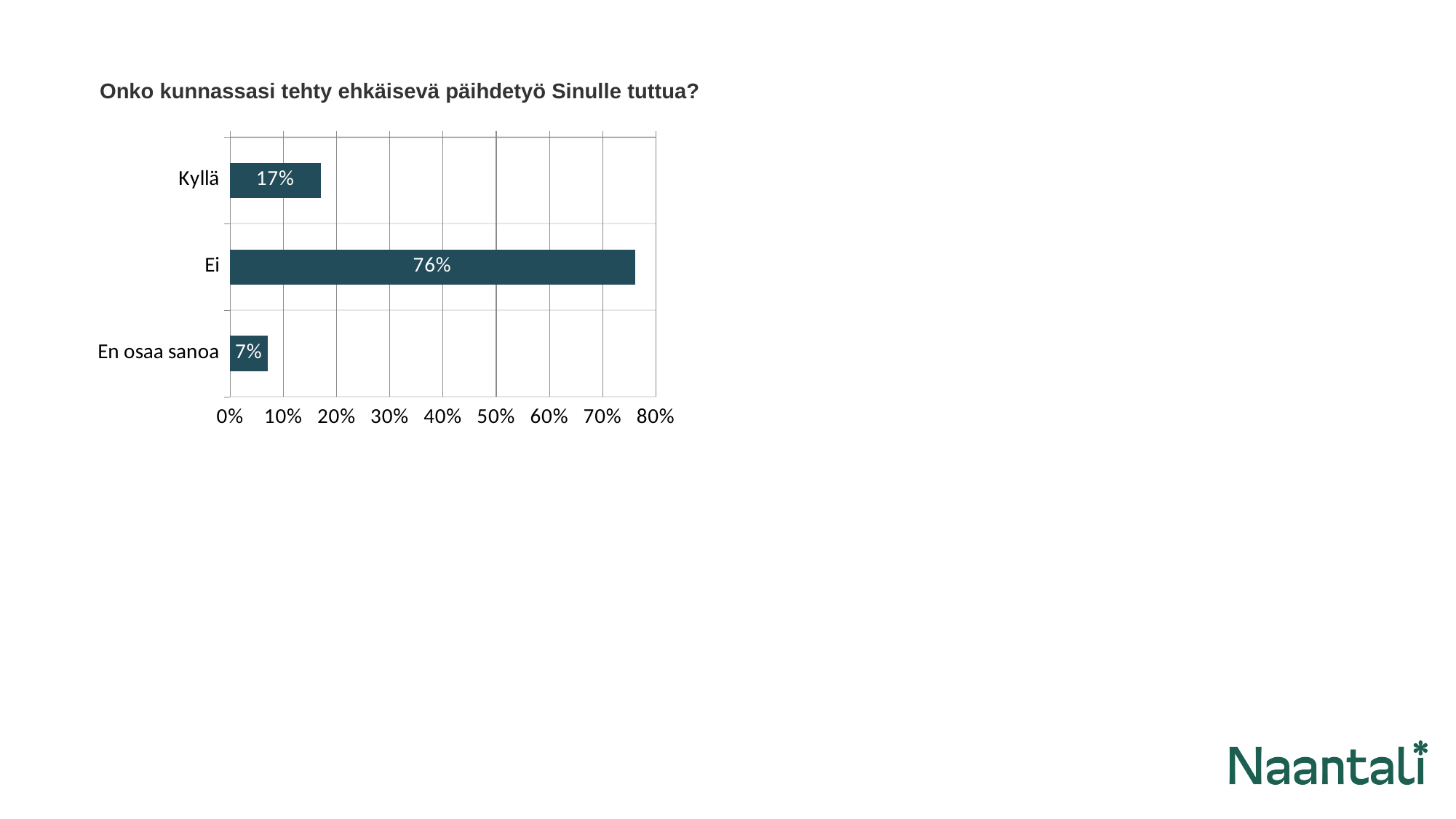
What kind of chart is shown on the slide? bar chart What is the difference between the values for Kyllä and En osaa sanoa? 10% Which category has the lowest value? En osaa sanoa Is the value for Ei greater or less than 50%? greater What is the value for Ei? 76% What is the difference between the values for Ei and Kyllä? 59% What is the value for Kyllä? 17% What is the title of the chart? Onko kunnassasi tehty ehkäisevä päihdetyö Sinulle tuttua? Which category has the highest value? Ei Which is larger, the value for Kyllä or the value for En osaa sanoa? Kyllä How many categories are shown in the chart? 3 What is the value for En osaa sanoa? 7%